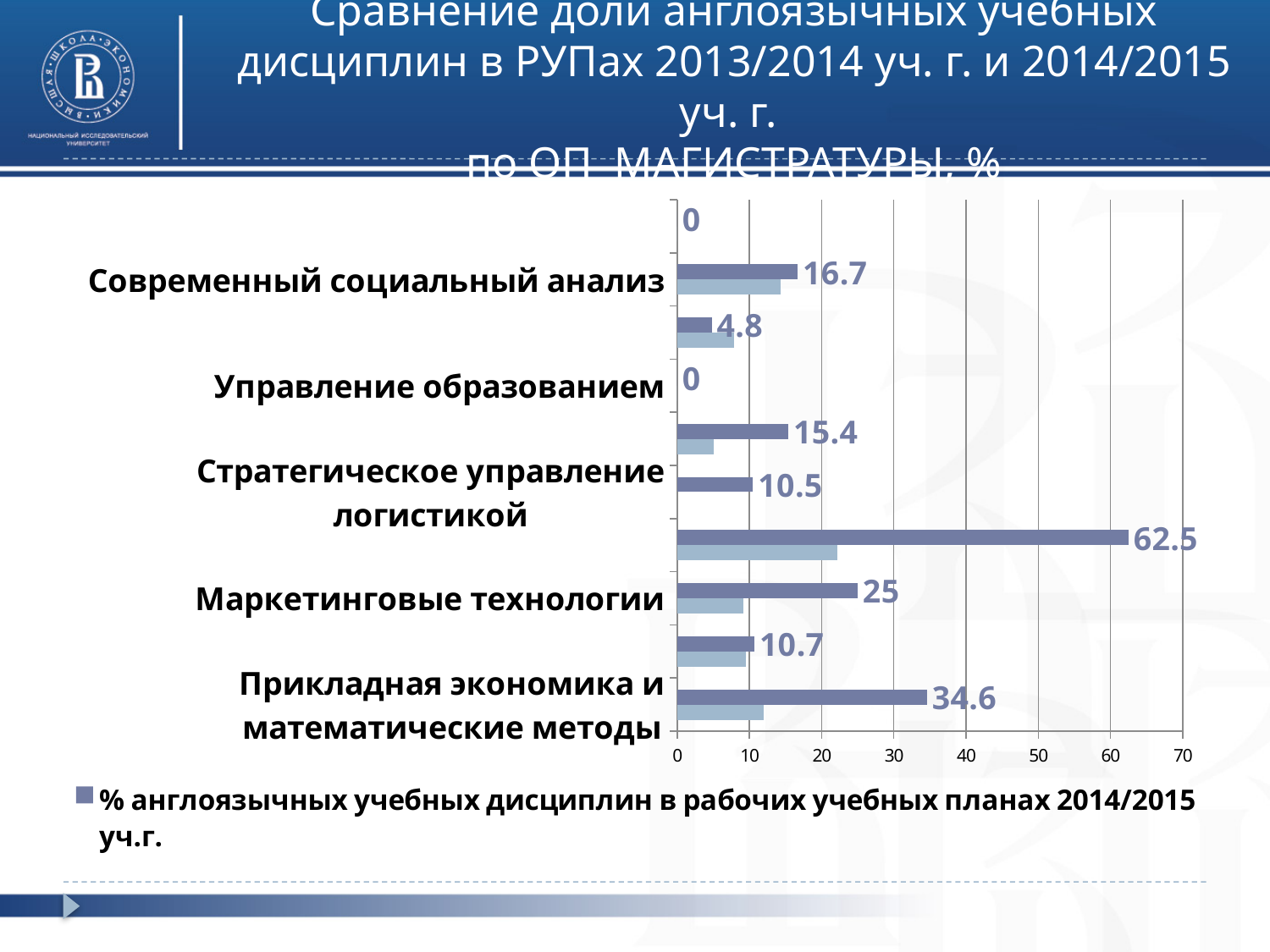
What is the 2014/2015 value for Маркетинговые технологии? 25 What is the 2014/2015 value for Современный социальный анализ? 16.7 What is the 2014/2015 value for Прикладная экономика и математические методы? 34.6 What is the difference between the 2014/2015 values for Прикладная экономика и математические методы and Маркетинговые технологии? 9.6 What type of chart is shown on the slide? bar chart Which has the higher 2014/2015 value: Маркетинговые технологии or Прикладная экономика и математические методы? Прикладная экономика и математические методы What is the largest data label shown on the chart? 62.5 What is the 2014/2015 value for Стратегическое управление логистикой? 10.5 What is the maximum value shown on the horizontal axis? 70 Is the light blue bar for Прикладная экономика и математические методы greater or less than 10? greater What is the 2014/2015 value for Управление образованием? 0 What is the difference between the 2014/2015 values for Современный социальный анализ and Стратегическое управление логистикой? 6.2